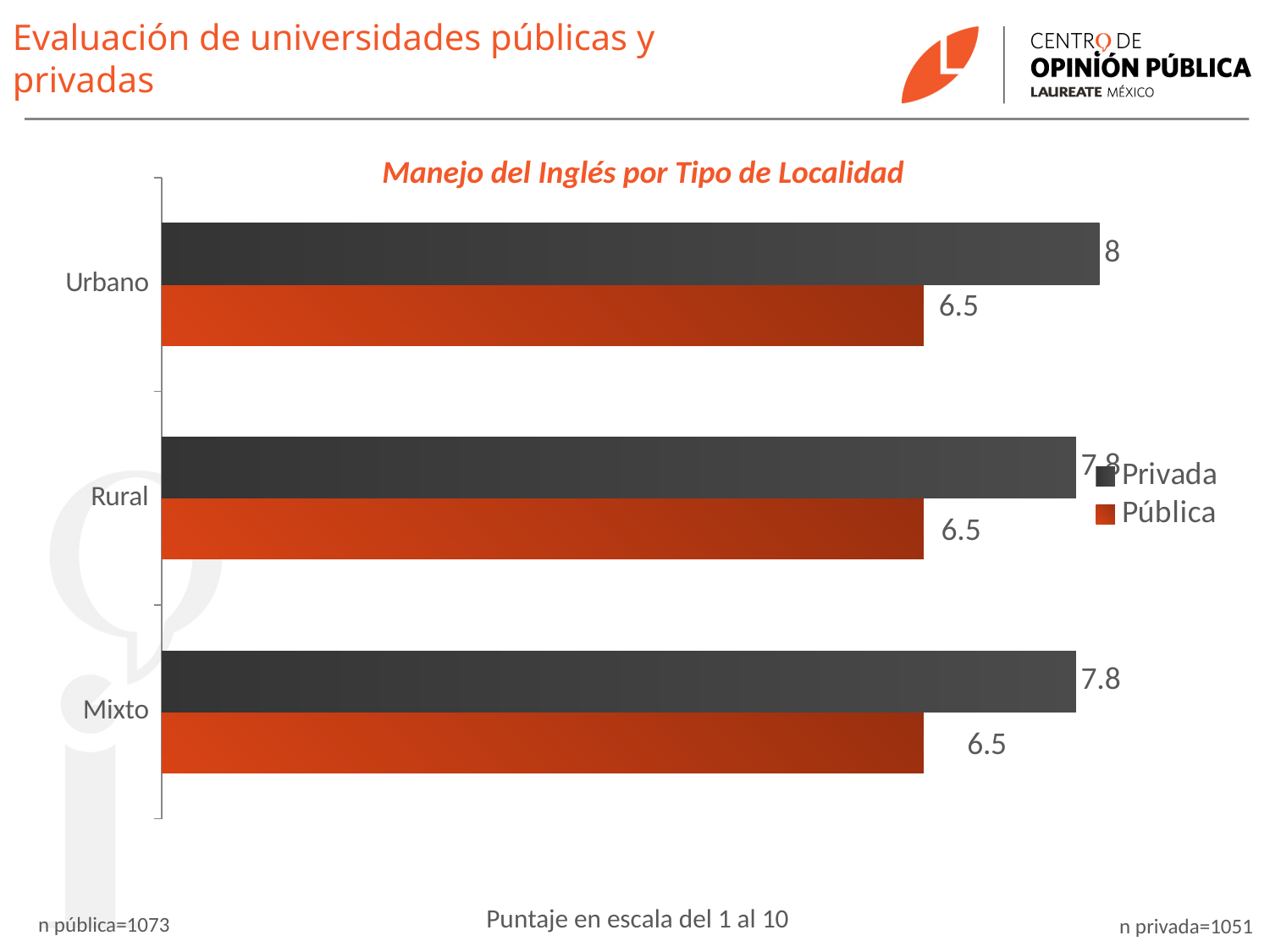
How many series does the legend list? 2 What is the Privada value for Urbano? 8 What is the Pública value for Mixto? 6.5 What is the difference between the Privada and Pública values for Mixto? 1.3 What is the Privada value for Mixto? 7.8 What is the Pública value for Rural? 6.5 Which locality type has the highest Privada value? Urbano What is the Pública value for Urbano? 6.5 How many locality types are shown on the chart? 3 For Urbano, which is larger, the Privada value or the Pública value? Privada What kind of chart is shown? Bar chart What is the difference between the Privada and Pública values for Urbano? 1.5